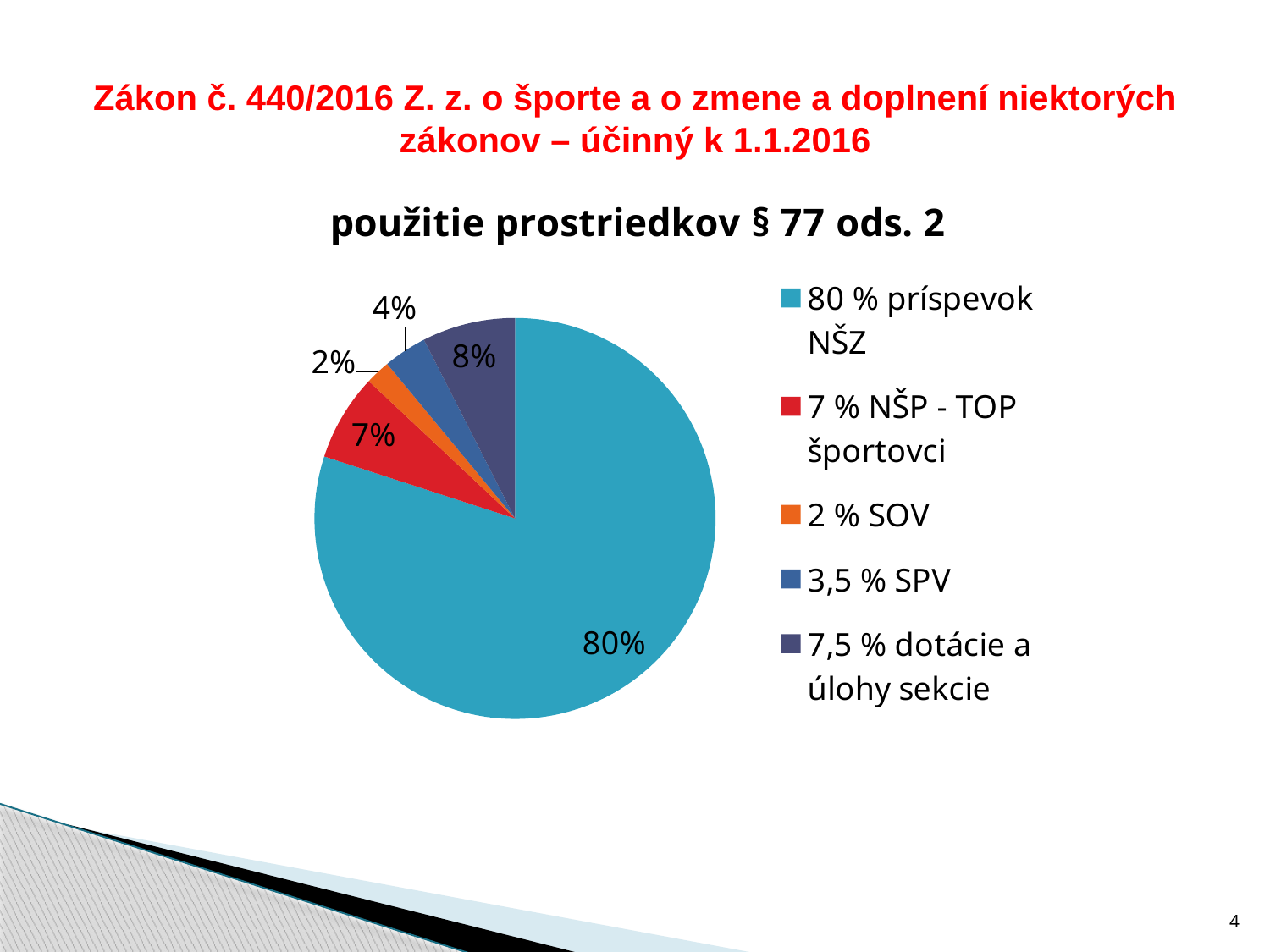
What is the difference in percentage points between the data labels for "80 % príspevok NŠZ" and "7,5 % dotácie a úlohy sekcie"? 72 What data label is shown on the slice for "80 % príspevok NŠZ"? 80% What is the title of the chart? použitie prostriedkov § 77 ods. 2 Which slice is larger, "7 % NŠP - TOP športovci" or "2 % SOV"? 7 % NŠP - TOP športovci Which legend category has the largest slice of the pie? 80 % príspevok NŠZ What data label is shown on the slice for "3,5 % SPV"? 4% How many slices does the pie chart have? 5 What data label is shown on the slice for "7,5 % dotácie a úlohy sekcie"? 8% What kind of chart is shown on the slide? pie chart What data label is shown on the slice for "7 % NŠP - TOP športovci"? 7% What data label is shown on the slice for "2 % SOV"? 2% Which legend category has the smallest slice of the pie? 2 % SOV